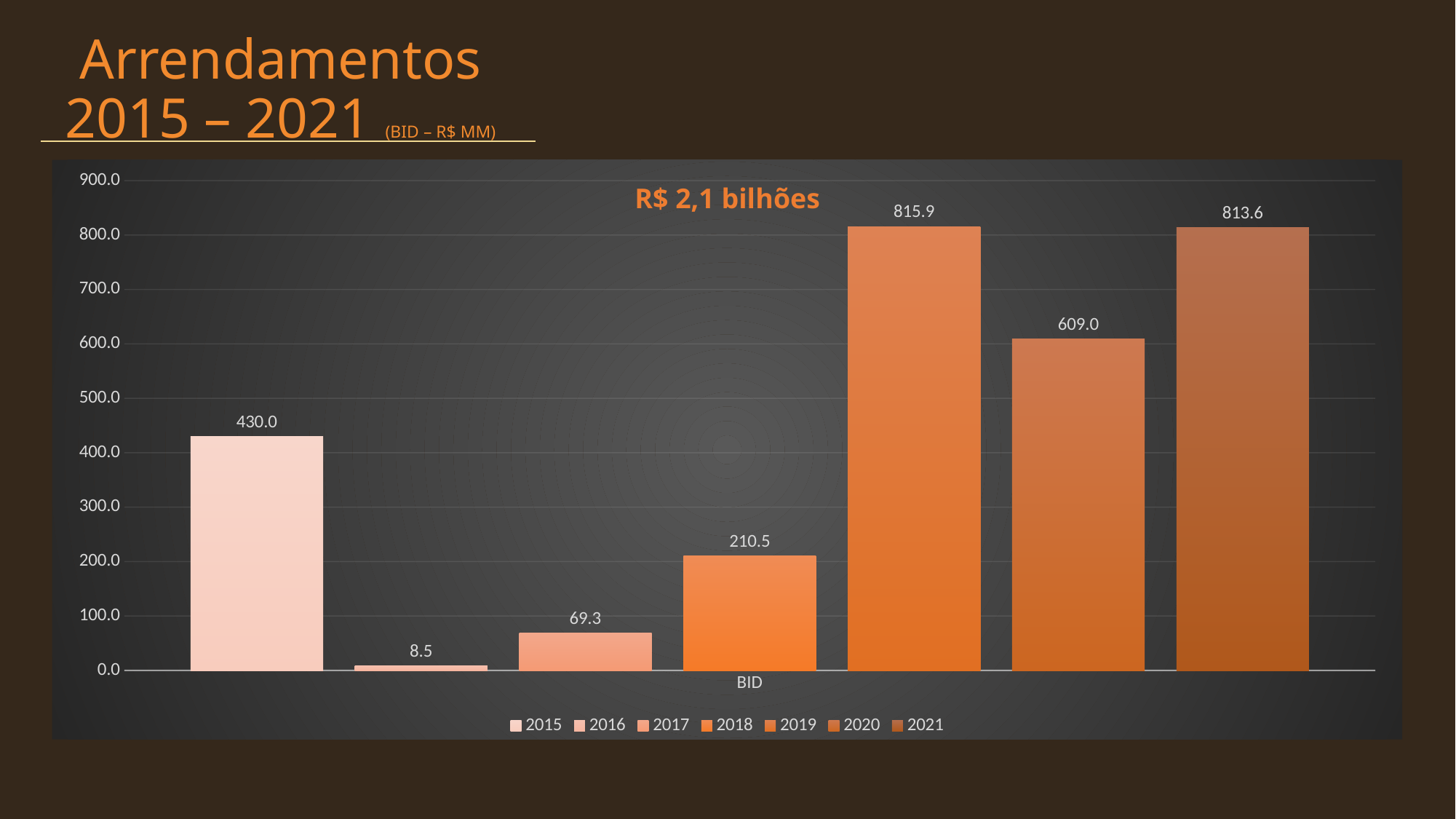
What is the value for 2015 in the chart? 430.0 What kind of chart is shown on the slide? Bar chart Which year has the lowest value in the chart? 2016 What is the difference between the values for 2019 and 2020? 206.9 What is the difference between the values for 2015 and 2018? 219.5 What text is annotated in orange above the bars in the chart? R$ 2,1 bilhões What is the value for 2019 in the chart? 815.9 How many series does the legend list? 7 What is the value for 2016 in the chart? 8.5 Which year has the highest value in the chart? 2019 What is the value for 2018 in the chart? 210.5 Which is larger, the value for 2017 or the value for 2018? 2018